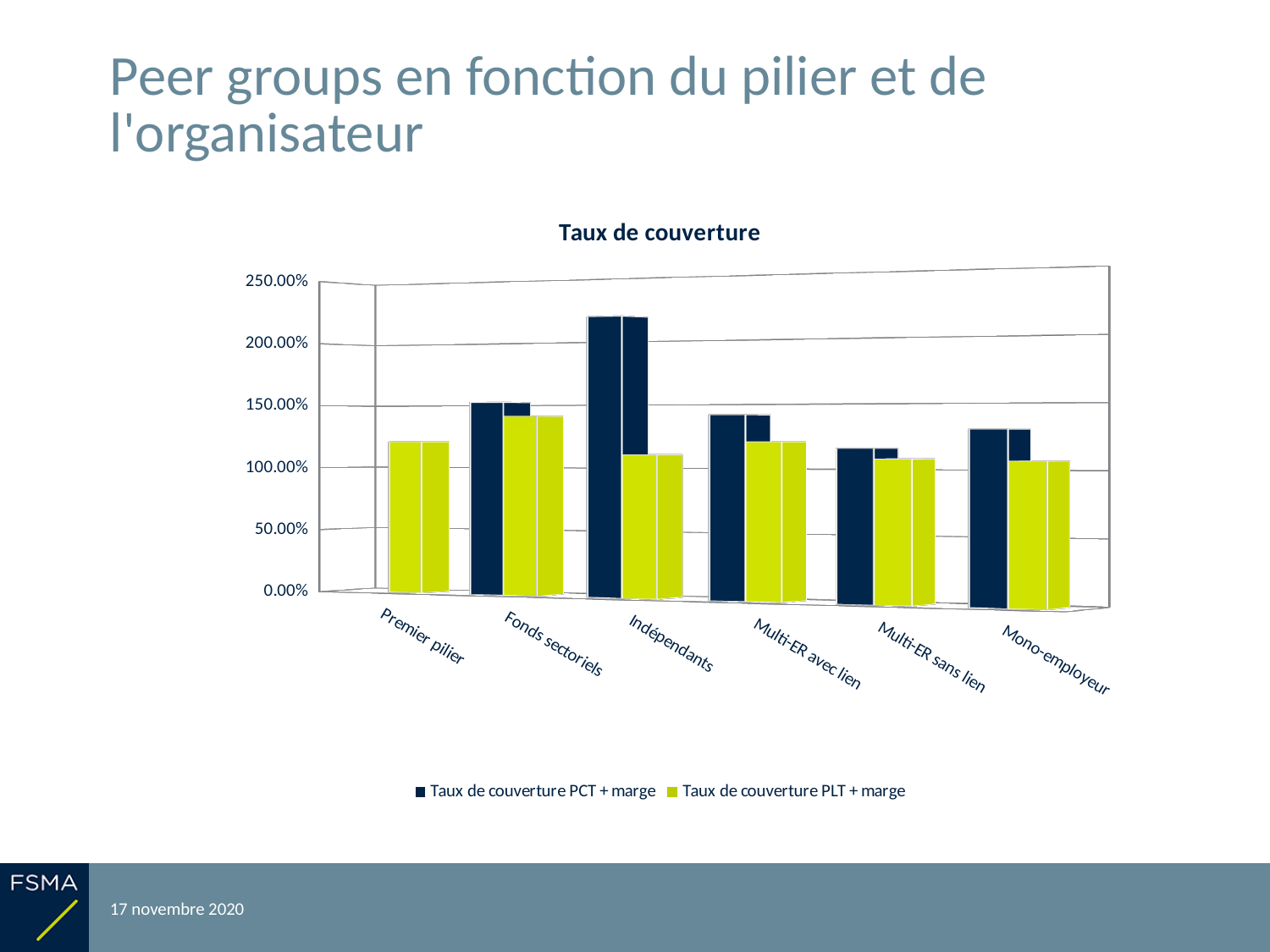
Which is larger: Taux de couverture PCT + marge for Fonds sectoriels or for Indépendants? Indépendants Which series is shown in dark navy in the legend? Taux de couverture PCT + marge For Indépendants, which is larger: Taux de couverture PCT + marge or Taux de couverture PLT + marge? Taux de couverture PCT + marge Is the value for Taux de couverture PCT + marge for Indépendants greater or less than 200.00%? greater Which category has the highest value for Taux de couverture PCT + marge? Indépendants Is the value for Taux de couverture PCT + marge for Multi-ER sans lien greater or less than 150.00%? less How many series does the legend list? 2 Is the value for Taux de couverture PLT + marge for Indépendants greater or less than 150.00%? less What kind of chart is shown on the slide? bar chart What is the title of the chart? Taux de couverture How many categories are shown on the x axis? 6